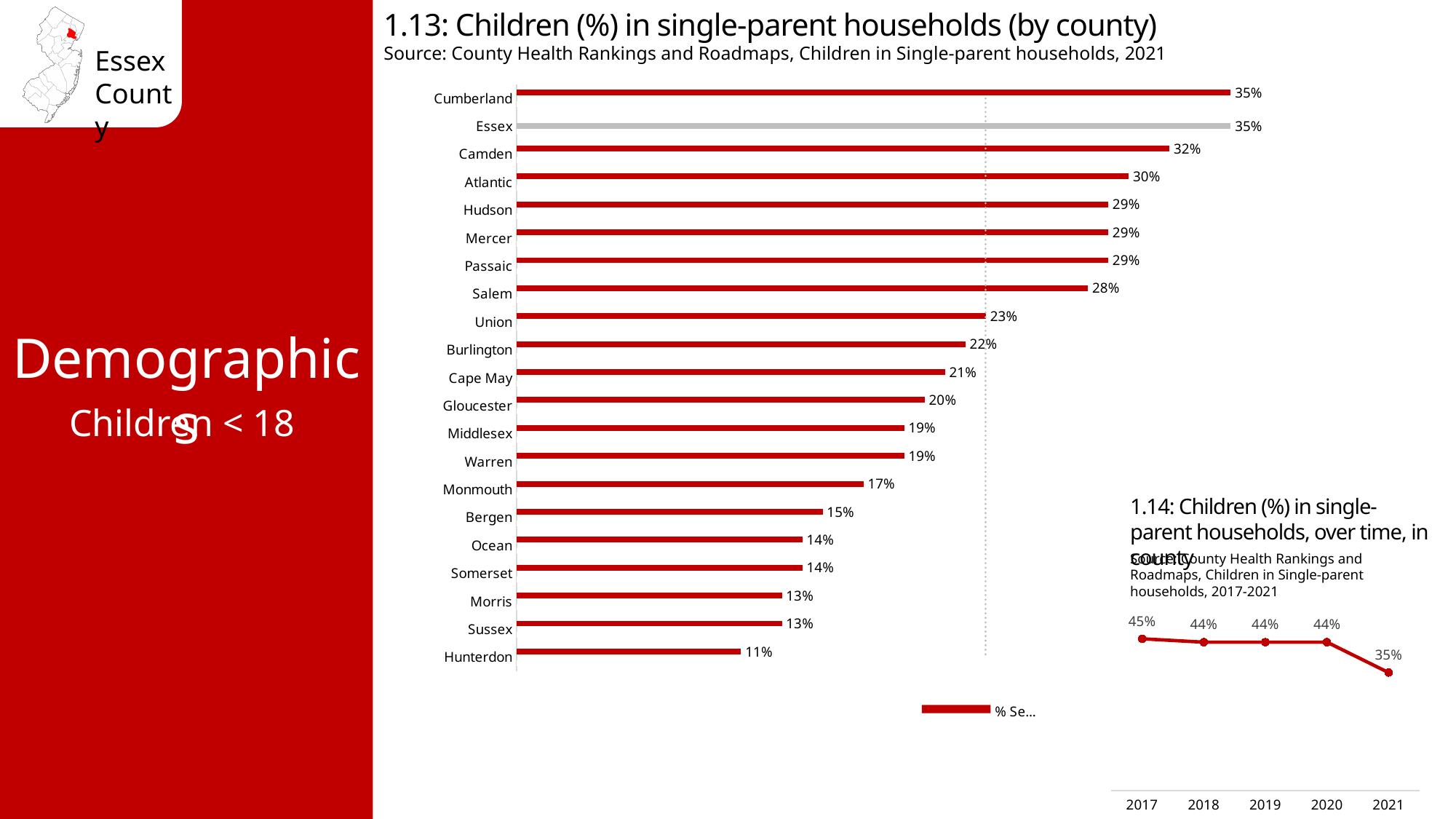
In chart 1.14 (over time, in county), what is the value for 2021? 35% In chart 1.13 (by county), which is larger, the value for Salem or the value for Union? Salem In chart 1.13 (by county), which county has the lowest value? Hunterdon In chart 1.13 (by county), what is the difference between the values for Atlantic and Bergen? 15% In chart 1.13 (by county), what is the value for Camden? 32% What kind of chart is chart 1.13 (by county)? Bar chart In chart 1.14 (over time, in county), what is the value for 2017? 45% In chart 1.13 (Children in single-parent households by county), what is the value for Essex? 35% In chart 1.14 (over time, in county), do the values rise or fall from 2017 to 2021? Fall In chart 1.13 (by county), what is the value for Monmouth? 17% In chart 1.14 (over time, in county), what is the difference between the values for 2020 and 2021? 9% In chart 1.13 (by county), how many counties are shown? 21